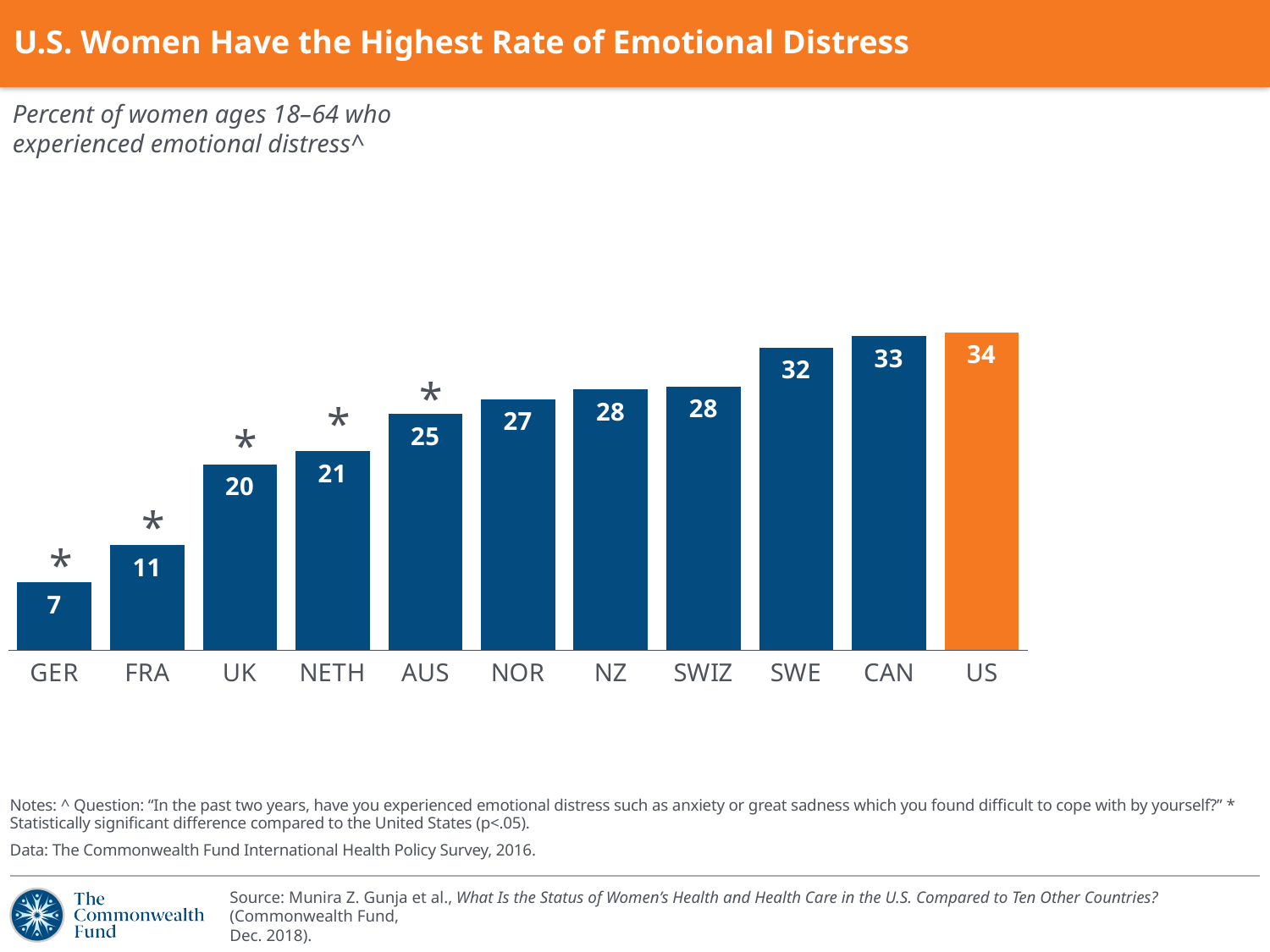
How many countries are shown on the chart? 11 Do the values rise or fall from left to right along the x axis? rise What is the difference between the values for US and GER? 27 Which country has the highest value? US Which bar is coloured orange rather than blue? US Which country has the lowest value? GER What kind of chart is this? bar chart What is the value for the US? 34 What is the difference between the values for CAN and UK? 13 Which is larger, the value for SWE or the value for AUS? SWE What is the value for GER? 7 What is the value for NETH? 21